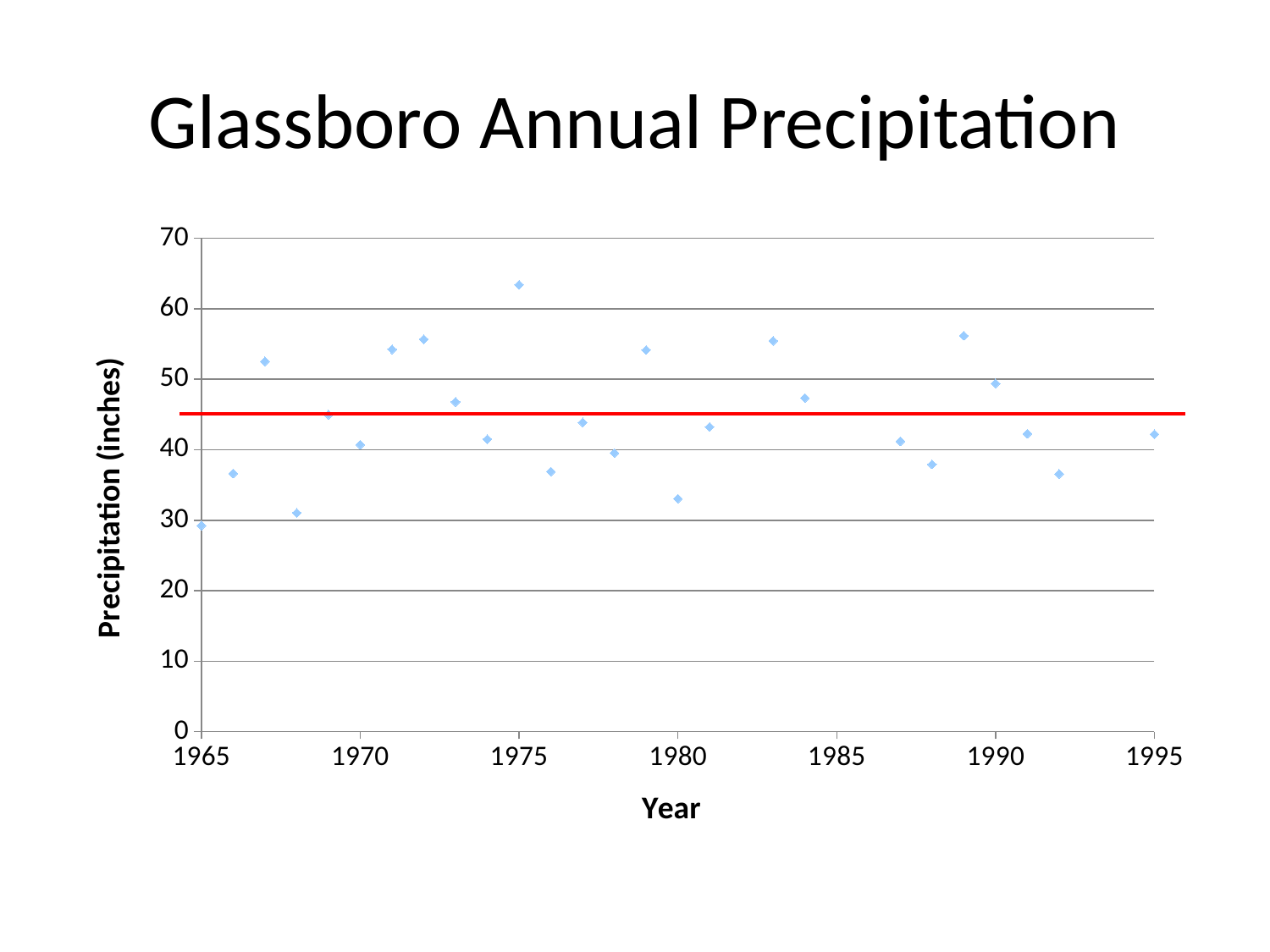
Which year has the highest precipitation value? 1975 What is the label of the vertical axis? Precipitation (inches) Which year has the larger precipitation value, 1990 or 1992? 1990 Which year has the larger precipitation value, 1967 or 1968? 1967 Is the precipitation value for 1965 greater or less than 30? less Is the precipitation value for 1972 greater or less than 50? greater Is the precipitation value for 1980 greater or less than 40? less What kind of chart is shown on the slide? scatter chart Which year has the lowest precipitation value? 1965 What is the title of the chart? Glassboro Annual Precipitation